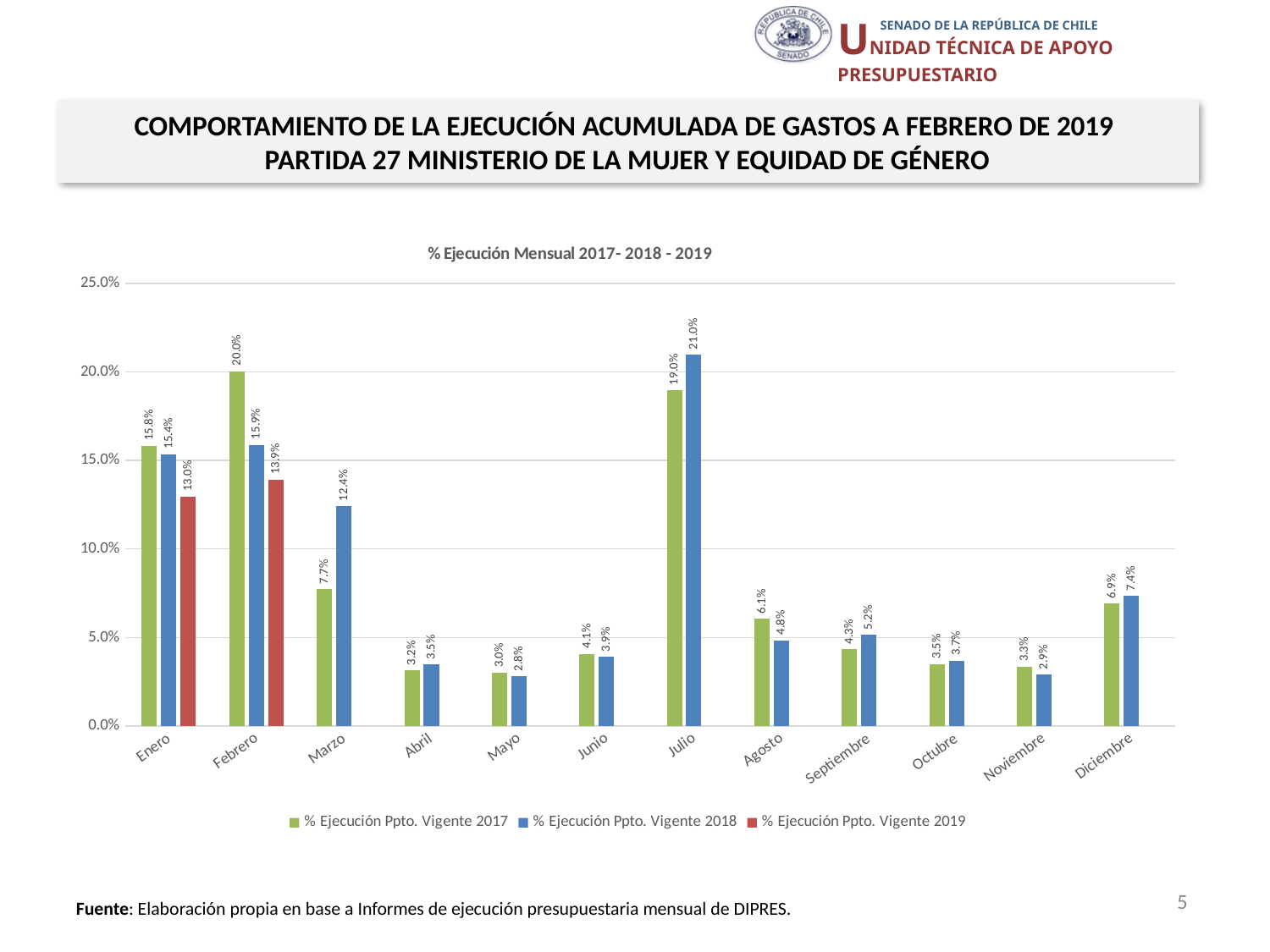
What is the difference between the 2017 and 2018 values in Febrero? 4.1% What is the value for % Ejecución Ppto. Vigente 2019 in Febrero? 13.9% How many months are shown on the x axis? 12 Which month has the lowest value for % Ejecución Ppto. Vigente 2017? Mayo What is the value for % Ejecución Ppto. Vigente 2018 in Marzo? 12.4% What is the value for % Ejecución Ppto. Vigente 2017 in Julio? 19.0% Is the value for % Ejecución Ppto. Vigente 2018 in Julio greater or less than 20.0%? greater Which is larger in Agosto: the 2017 value or the 2018 value? 2017 What is the title of the chart? % Ejecución Mensual 2017- 2018 - 2019 What kind of chart is shown on the slide? Bar chart Which month has the highest value for % Ejecución Ppto. Vigente 2018? Julio How many series does the legend list? 3